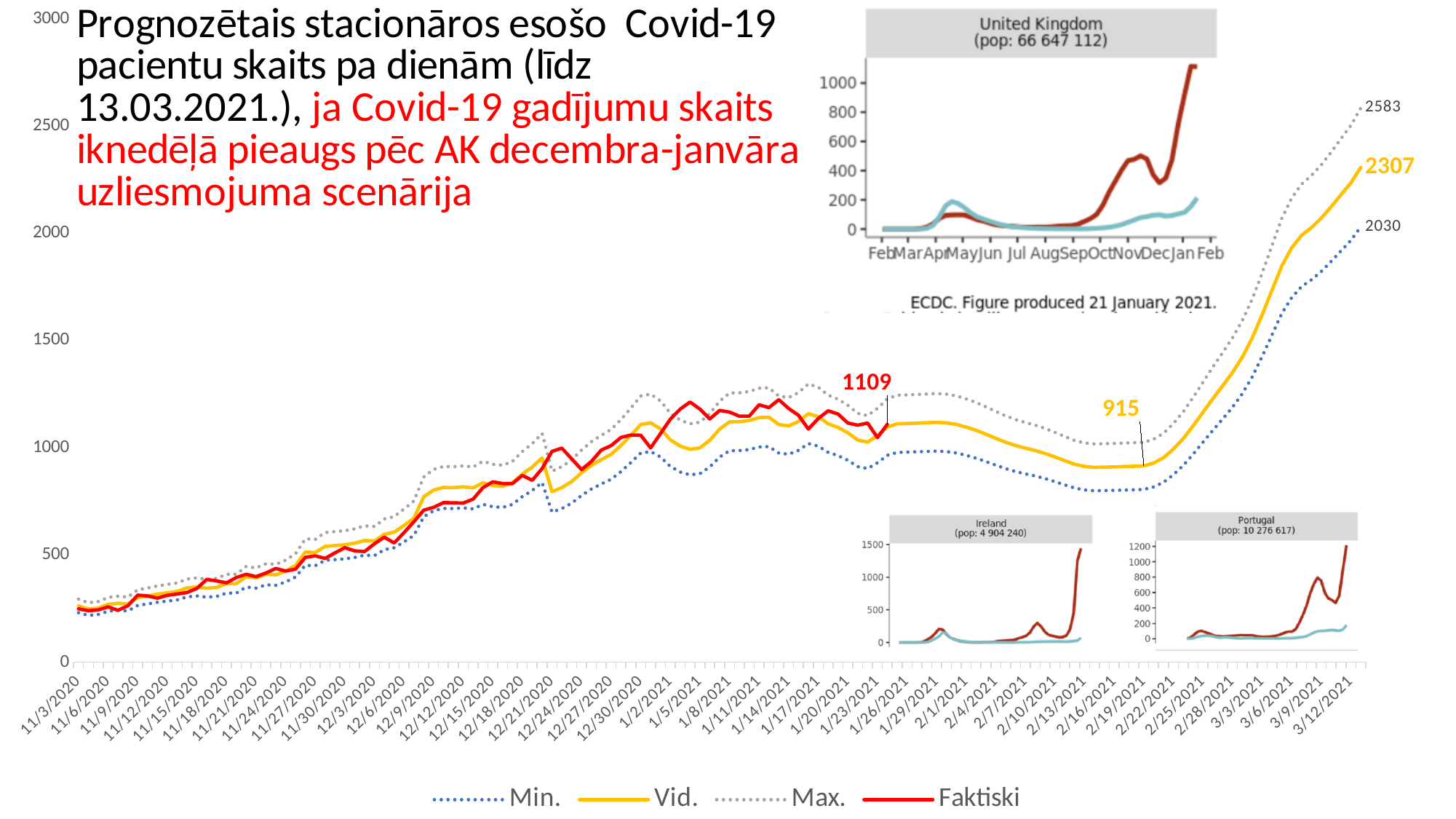
In the main chart, what is the difference between the Max. and Min. values labelled at 3/12/2021? 553 What kind of chart is the main chart on the slide? line chart In the main chart, does the Vid. series rise or fall between 2/19/2021 and 3/12/2021? rises In the main chart, what is the value labelled in yellow on the Vid. line near 2/19/2021? 915 How many series does the legend of the main chart list? 4 In the main chart, which series has the higher labelled value at 3/12/2021, Max. or Vid.? Max. In the main chart, what is the labelled value of the Vid. series at 3/12/2021? 2307 In the main chart, what is the labelled value of the Max. series at 3/12/2021? 2583 In the main chart, what is the value labelled in red on the Faktiski line? 1109 In the main chart, is the value of the Faktiski series at 11/3/2020 greater or less than 500? less In the main chart, what is the labelled value of the Min. series at 3/12/2021? 2030 In the main chart, what is the difference between the Vid. and Min. values labelled at 3/12/2021? 277